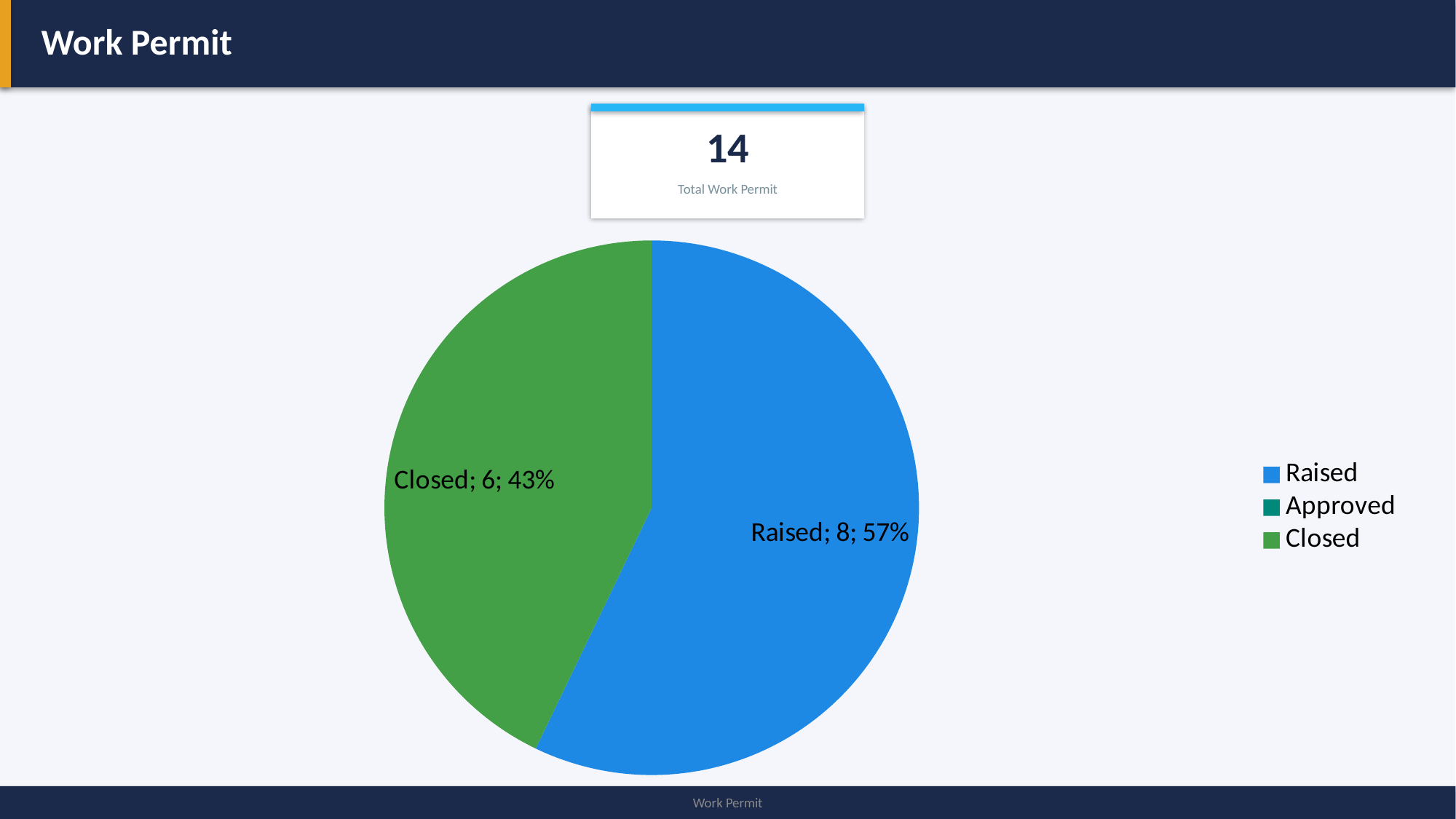
How many slices are visible in the pie chart? 2 What is the difference between the Raised and Closed values? 2 How many entries does the legend list? 3 What share of the pie does the Raised slice represent? 57% Which of the two visible slices is larger, Raised or Closed? Raised What is the value for Closed in the pie chart? 6 What colour is the Closed slice in the pie chart? green What kind of chart is shown on the slide? pie chart What is the value for Raised in the pie chart? 8 What is the Total Work Permit figure shown above the chart? 14 What share of the pie does the Closed slice represent? 43% Which slice is the largest in the pie chart? Raised